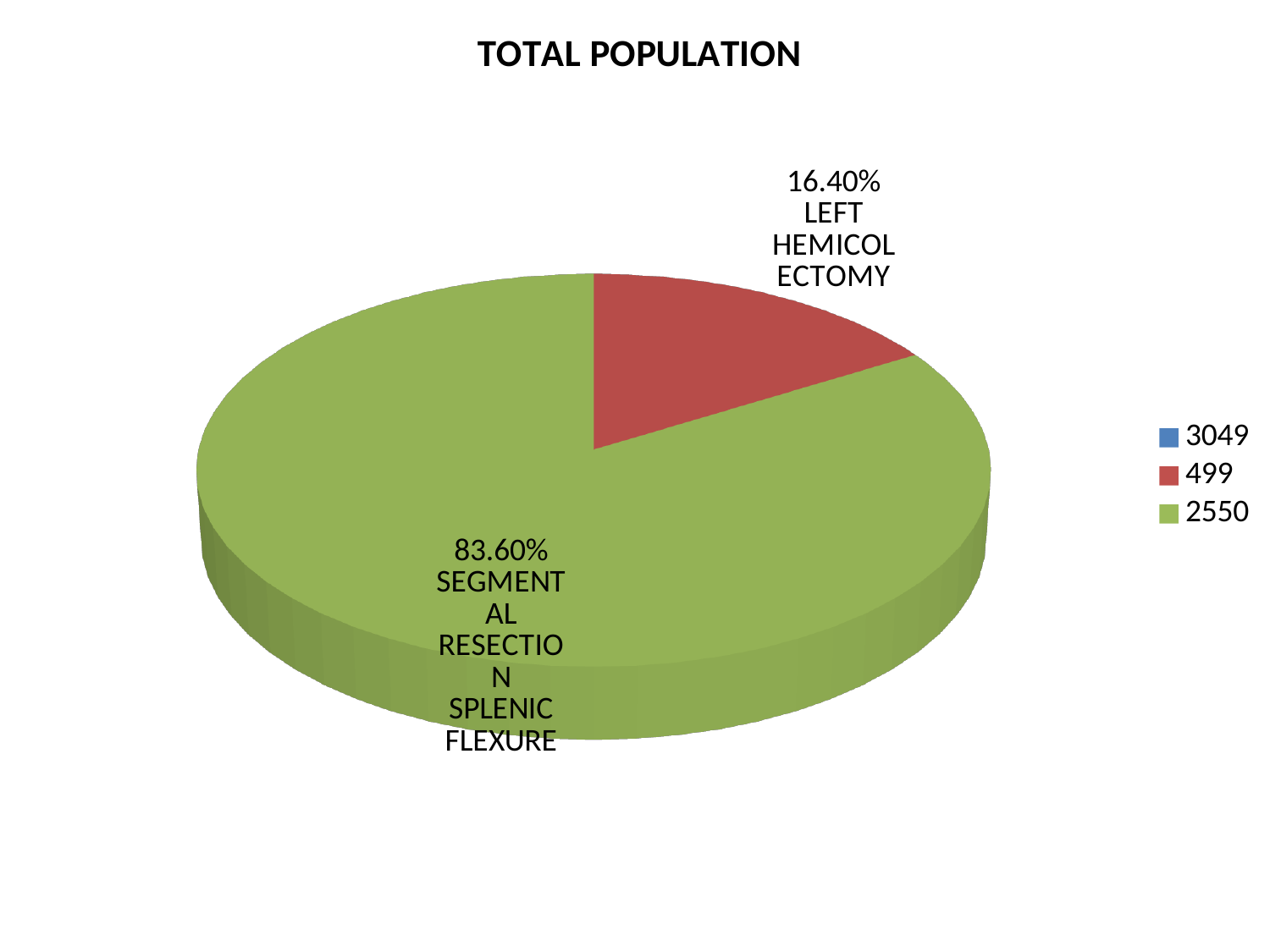
Which slice of the pie is the smallest? LEFT HEMICOLECTOMY What share of the pie does LEFT HEMICOLECTOMY represent? 16.40% Which slice of the pie is the largest? SEGMENTAL RESECTION SPLENIC FLEXURE Which is larger, the share for LEFT HEMICOLECTOMY or the share for SEGMENTAL RESECTION SPLENIC FLEXURE? SEGMENTAL RESECTION SPLENIC FLEXURE What is the difference in percentage points between the SEGMENTAL RESECTION SPLENIC FLEXURE share and the LEFT HEMICOLECTOMY share? 67.20% What kind of chart is shown on the slide? pie chart How many entries does the legend list? 3 How many slices are visible in the pie chart? 2 Is the share for LEFT HEMICOLECTOMY greater or less than 20%? less What share of the pie does SEGMENTAL RESECTION SPLENIC FLEXURE represent? 83.60% What colour is the LEFT HEMICOLECTOMY slice? red What is the title of the chart? TOTAL POPULATION